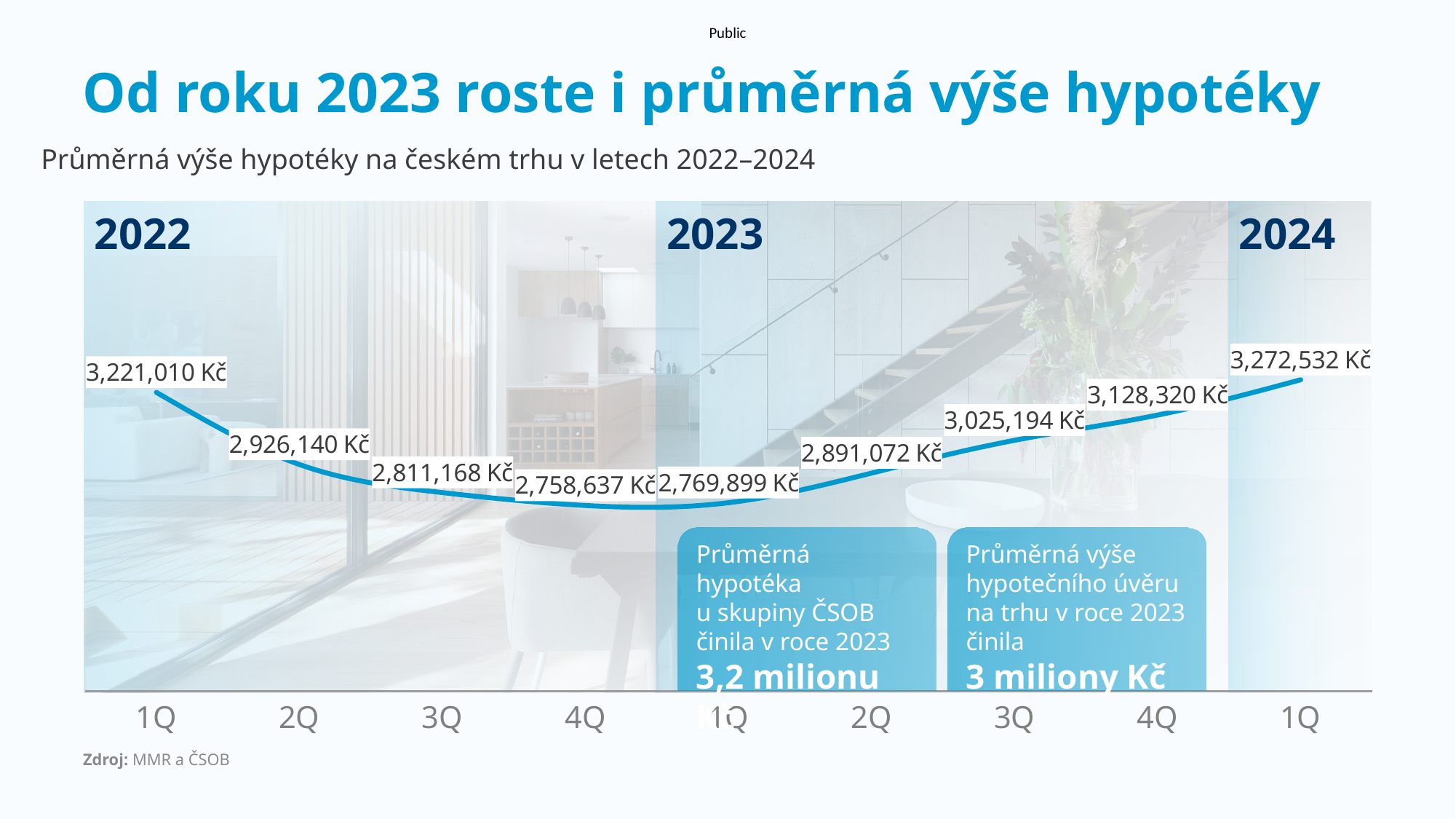
How many data points are plotted on the chart? 9 Which quarter has the highest average mortgage amount? 1Q 2024 What was the average mortgage amount in 1Q 2022? 3,221,010 Kč What value is shown for 2Q 2023? 2,891,072 Kč What type of chart is shown on the slide? line chart What was the average mortgage amount in 4Q 2023? 3,128,320 Kč What value is shown for 1Q 2024? 3,272,532 Kč Which is larger, the value for 2Q 2022 or the value for 3Q 2023? 3Q 2023 What is the difference between the values for 4Q 2023 and 3Q 2023? 103,126 Kč Which quarter has the lowest average mortgage amount? 4Q 2022 How much higher is the value for 1Q 2024 than the value for 1Q 2022? 51,522 Kč Do the values rise or fall from 1Q 2023 to 1Q 2024? rise